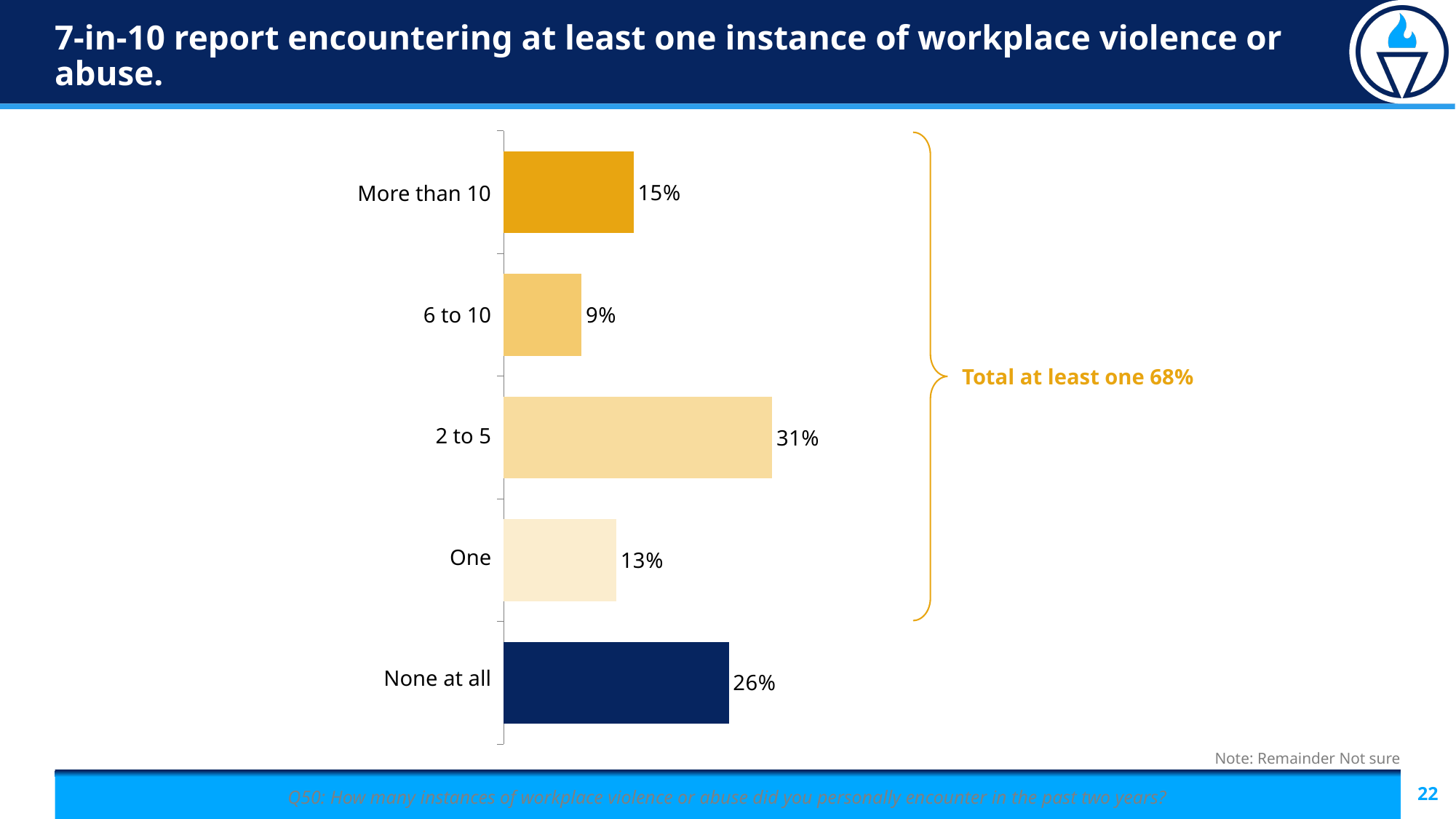
Which is larger, the value for 'More than 10' or the value for 'One'? More than 10 Which category has the lowest value? 6 to 10 What is the combined value of the 'One' and '6 to 10' categories? 22% What is the value for 'None at all'? 26% What is the value shown for the '6 to 10' category? 9% What percentage of respondents reported encountering more than 10 instances of workplace violence or abuse? 15% Which category has the highest value? 2 to 5 What percentage reported '2 to 5' instances? 31% What is the difference between the '2 to 5' value and the 'None at all' value? 5% What kind of chart is shown on the slide? Bar chart What total percentage does the bracket label give for respondents reporting at least one instance? 68% How many categories are shown in the chart? 5